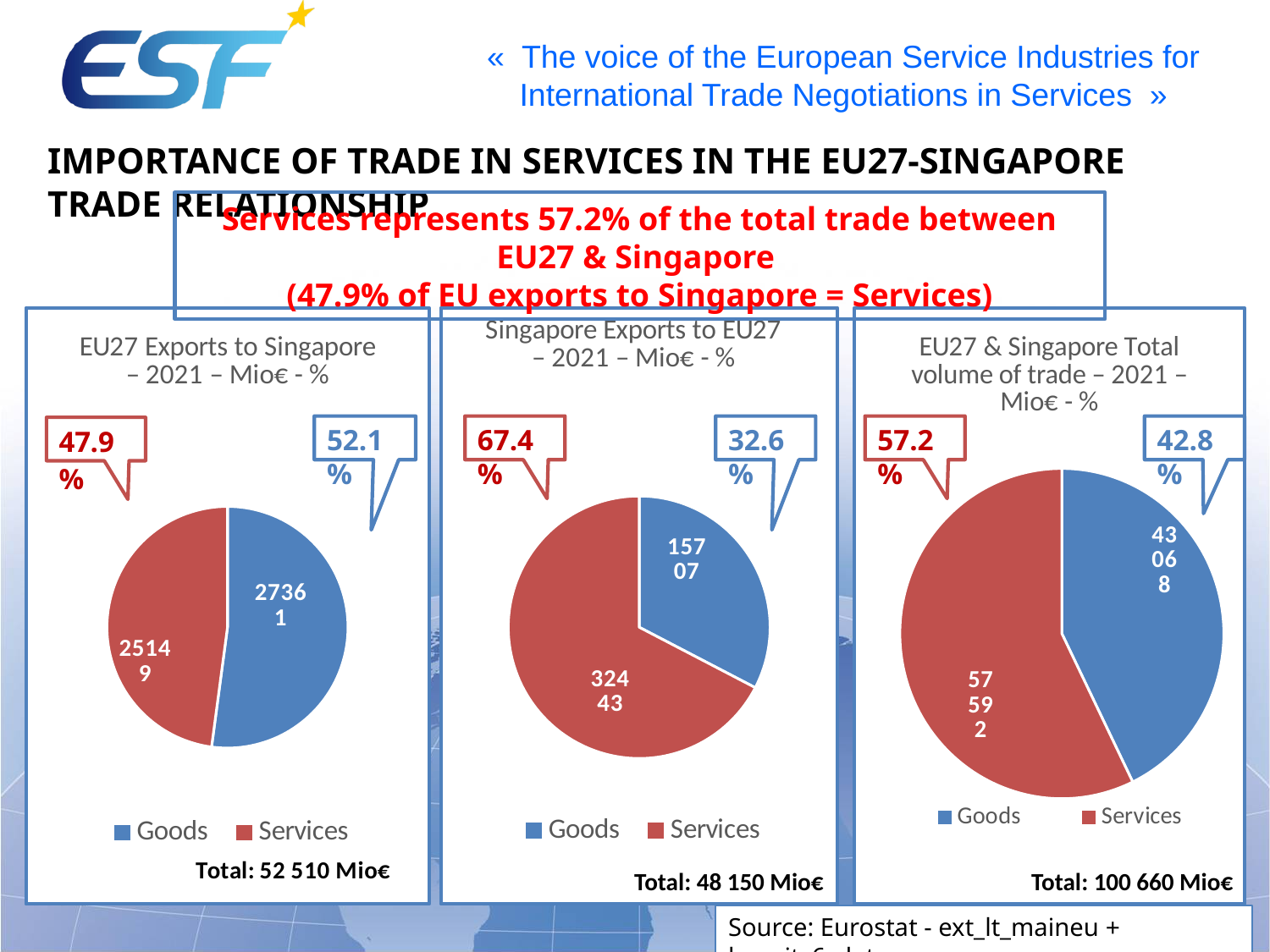
In the 'EU27 Exports to Singapore – 2021' chart, which slice is larger, Goods or Services? Goods What total is printed under the 'EU27 & Singapore Total volume of trade – 2021' chart? 100 660 Mio€ In the 'Singapore Exports to EU27 – 2021' chart, which slice is larger, Goods or Services? Services In the 'Singapore Exports to EU27 – 2021' chart, what is the difference between the Services value (32443) and the Goods value (15707)? 16736 In the 'EU27 Exports to Singapore – 2021' chart, what share of the pie is Services? 47.9% In the pie charts, which colour represents Services? red In the 'Singapore Exports to EU27 – 2021' chart, how many entries does the legend list? 2 How many pie charts are shown on the slide? 3 In the 'Singapore Exports to EU27 – 2021' chart, what share of the pie is Goods? 32.6% What kind of chart is used in the 'EU27 Exports to Singapore – 2021' chart? pie chart What total is printed under the 'Singapore Exports to EU27 – 2021' chart? 48 150 Mio€ In the 'EU27 & Singapore Total volume of trade – 2021' chart, what share of the pie is Services? 57.2%